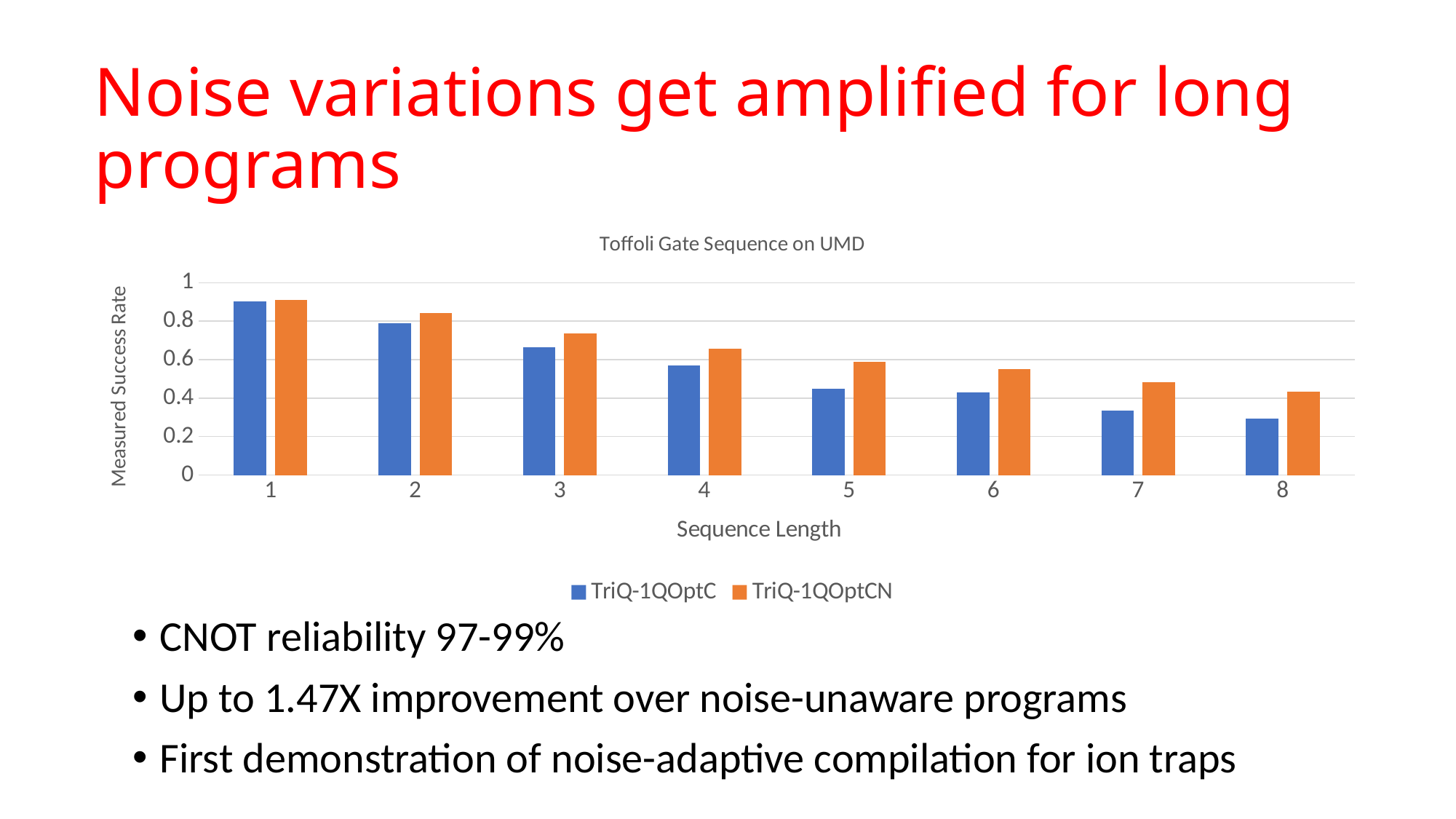
What kind of chart is shown on the slide? bar chart At sequence length 6, which series has the larger value, TriQ-1QOptC or TriQ-1QOptCN? TriQ-1QOptCN Is the TriQ-1QOptC value at sequence length 7 greater or less than 0.4? less How many sequence lengths are plotted on the x axis? 8 What is the label of the y axis? Measured Success Rate How many series does the chart legend list? 2 Is the TriQ-1QOptCN value at sequence length 8 greater or less than 0.6? less What is the title of the chart? Toffoli Gate Sequence on UMD At which sequence length is the TriQ-1QOptCN value lowest? 8 Is the TriQ-1QOptC value at sequence length 1 greater or less than 0.8? greater Do the TriQ-1QOptC values rise or fall as sequence length increases? fall At which sequence length is the TriQ-1QOptC value highest? 1